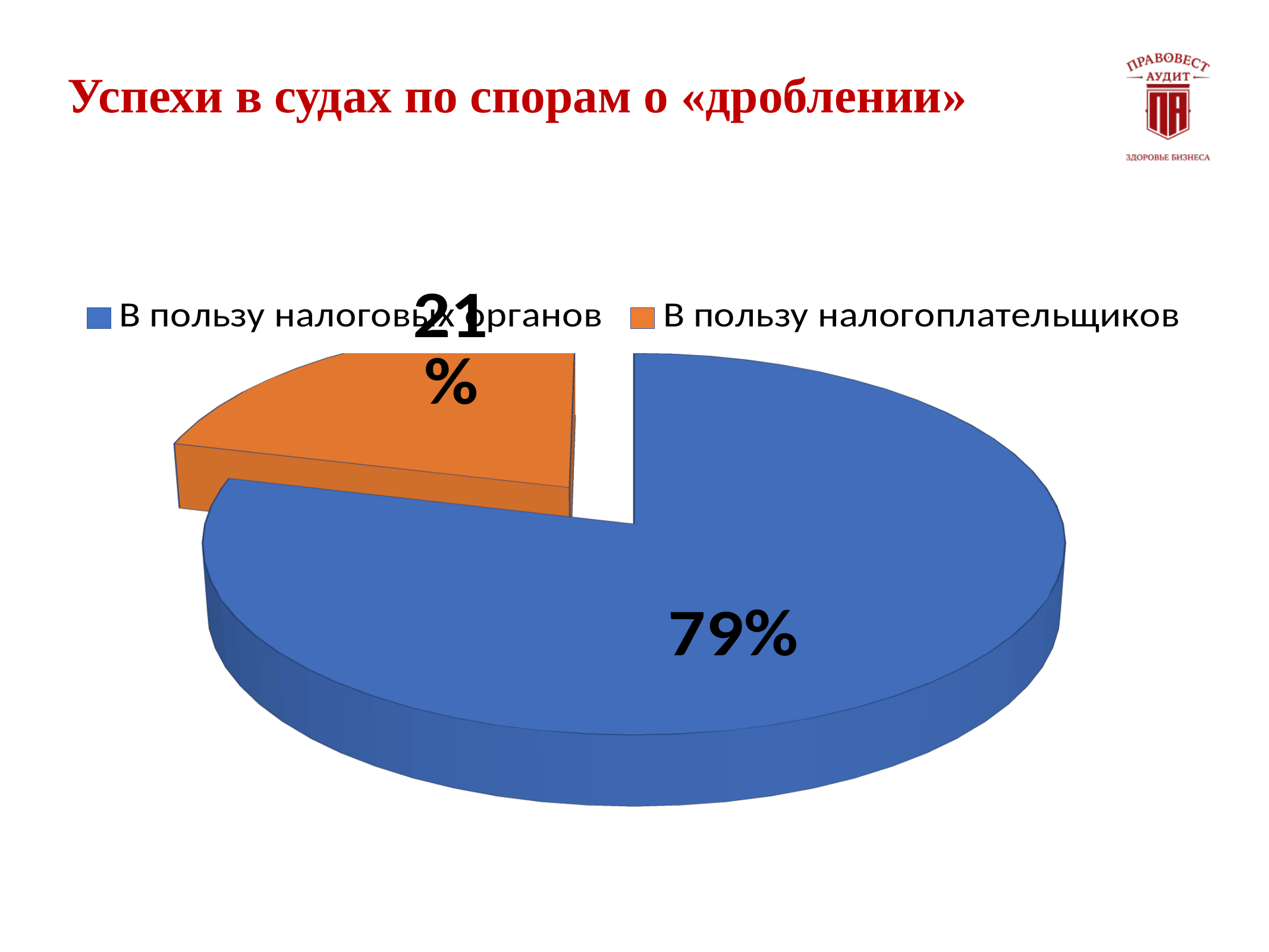
What kind of chart is shown on the slide? Pie chart What share of the pie is labelled for 'В пользу налогоплательщиков'? 21% What is the difference in percentage points between the 'В пользу налоговых органов' slice and the 'В пользу налогоплательщиков' slice? 58 Which category has the largest slice of the pie? В пользу налоговых органов What share of the pie is labelled for 'В пользу налоговых органов'? 79% How many slices does the pie chart have? 2 What is the title of the slide containing the pie chart? Успехи в судах по спорам о «дроблении» How many entries does the legend list? 2 Which category has the smallest slice of the pie? В пользу налогоплательщиков What colour is the slice for 'В пользу налогоплательщиков'? Orange Which is larger: the slice for 'В пользу налоговых органов' or the slice for 'В пользу налогоплательщиков'? В пользу налоговых органов